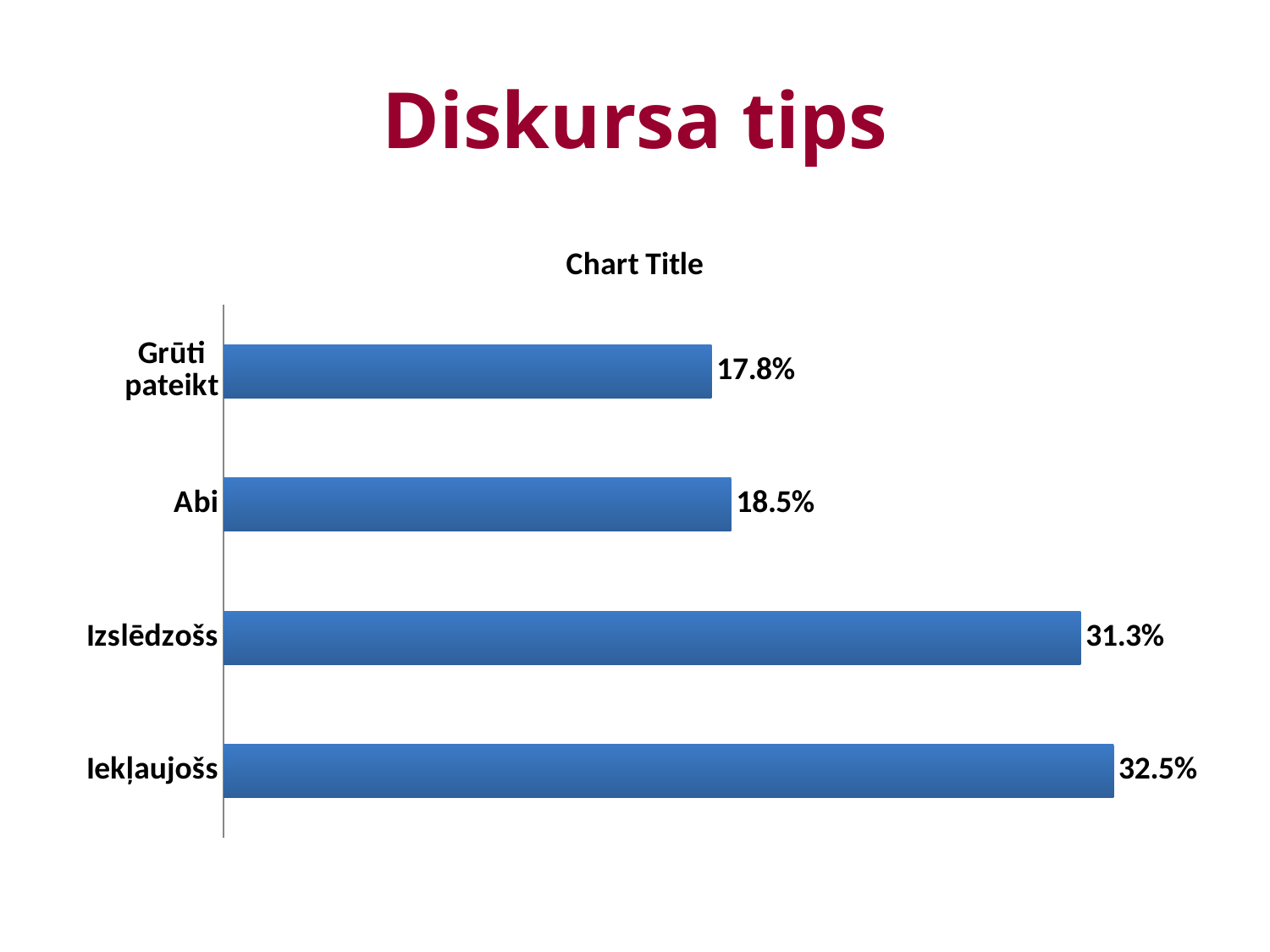
What is the value for Grūti pateikt? 17.8% Which is larger, the value for Izslēdzošs or the value for Abi? Izslēdzošs Which category has the lowest value? Grūti pateikt What is the title of the slide? Diskursa tips What is the difference between the values for Abi and Grūti pateikt? 0.7% What kind of chart is shown on the slide? Bar chart What is the value for Abi? 18.5% What is the value for Iekļaujošs? 32.5% Which category has the highest value? Iekļaujošs What is the difference between the values for Iekļaujošs and Izslēdzošs? 1.2% How many categories are shown in the chart? 4 What is the value for Izslēdzošs? 31.3%